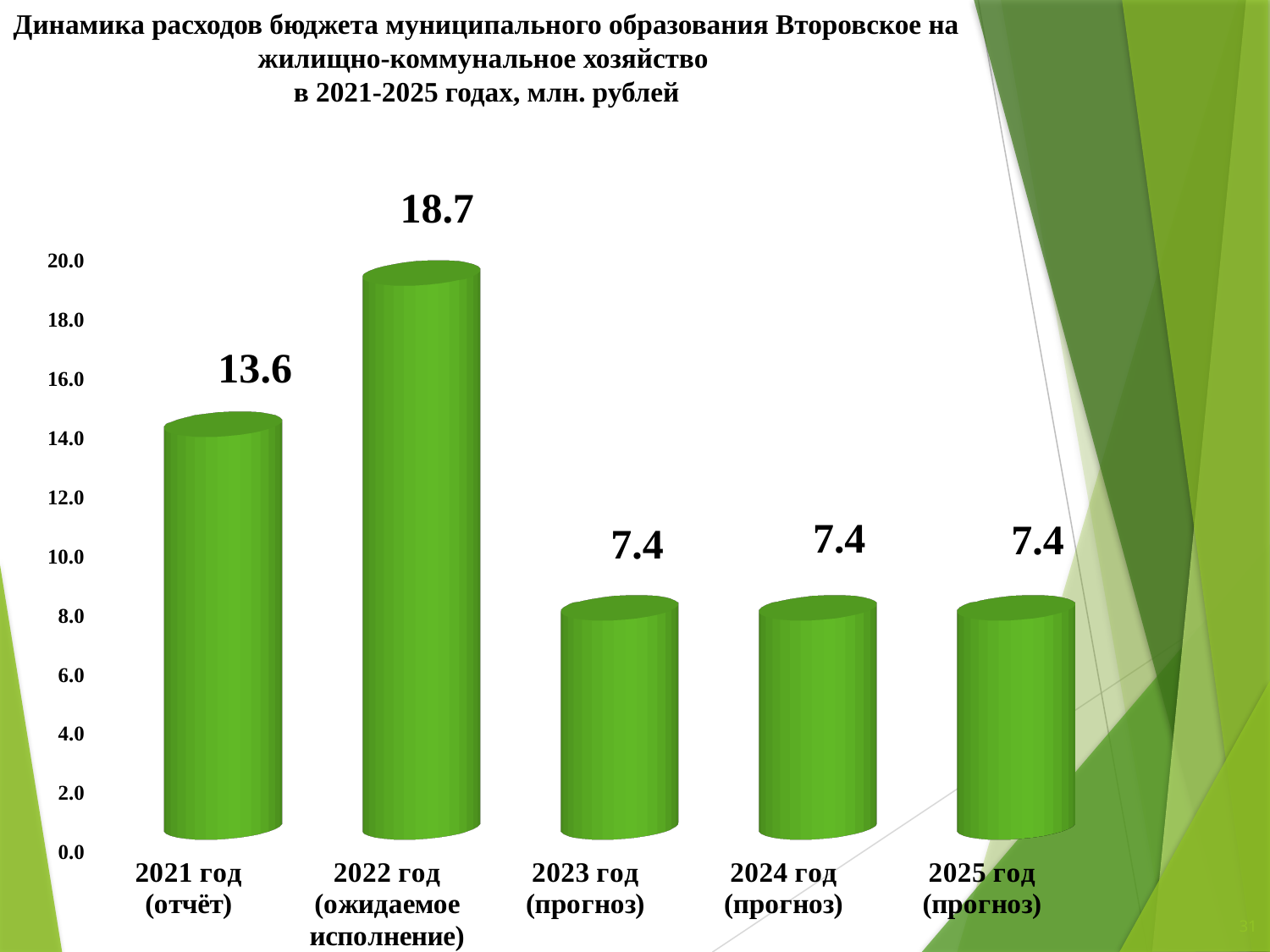
What is the value for 2021 год (отчёт)? 13.6 What is the value for 2024 год (прогноз)? 7.4 Which year has the highest value? 2022 год (ожидаемое исполнение) What is the difference between the values for 2022 год and 2021 год? 5.1 Is the value for 2023 год greater or less than 10.0? less What kind of chart is shown on the slide? bar chart Which is larger, the value for 2021 год or the value for 2025 год? 2021 год Is the value for 2022 год greater or less than 16.0? greater What is the value for 2022 год (ожидаемое исполнение)? 18.7 What is the difference between the values for 2021 год and 2023 год? 6.2 Do the values rise or fall from 2022 год to 2023 год? fall How many years are shown on the chart? 5